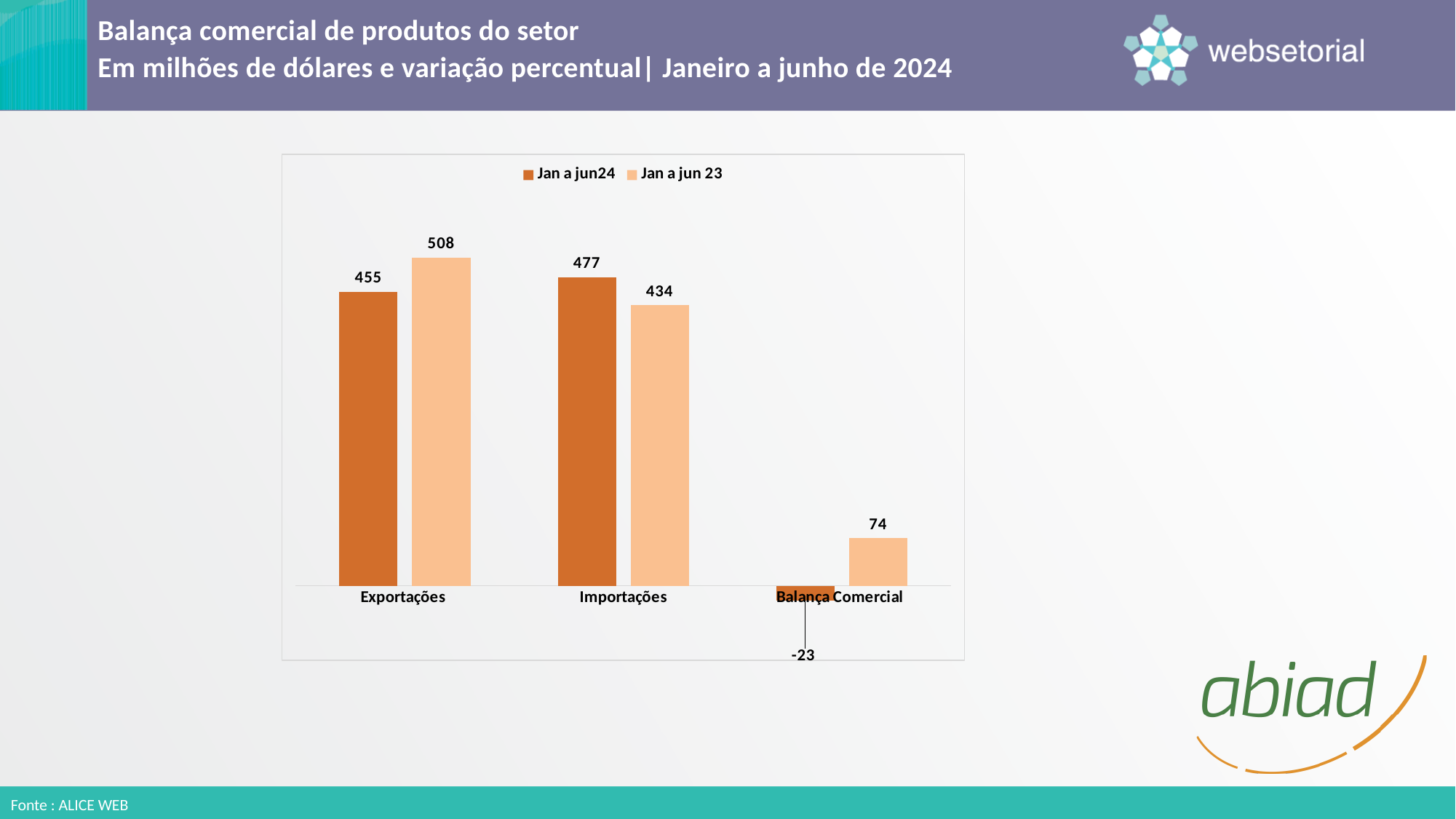
How many series does the legend list? 2 How many categories are shown on the x axis? 3 What is the value for Balança Comercial in the Jan a jun 23 series? 74 What kind of chart is shown on the slide? Bar chart Which category has the highest value in the Jan a jun 23 series? Exportações What is the difference between the Jan a jun 23 and Jan a jun24 values for Exportações? 53 What is the value for Importações in the Jan a jun24 series? 477 Which is larger for Importações: the Jan a jun24 value or the Jan a jun 23 value? Jan a jun24 What is the value for Exportações in the Jan a jun24 series? 455 What is the value for Balança Comercial in the Jan a jun24 series? -23 What is the value for Exportações in the Jan a jun 23 series? 508 Which category has the lowest value in the Jan a jun24 series? Balança Comercial